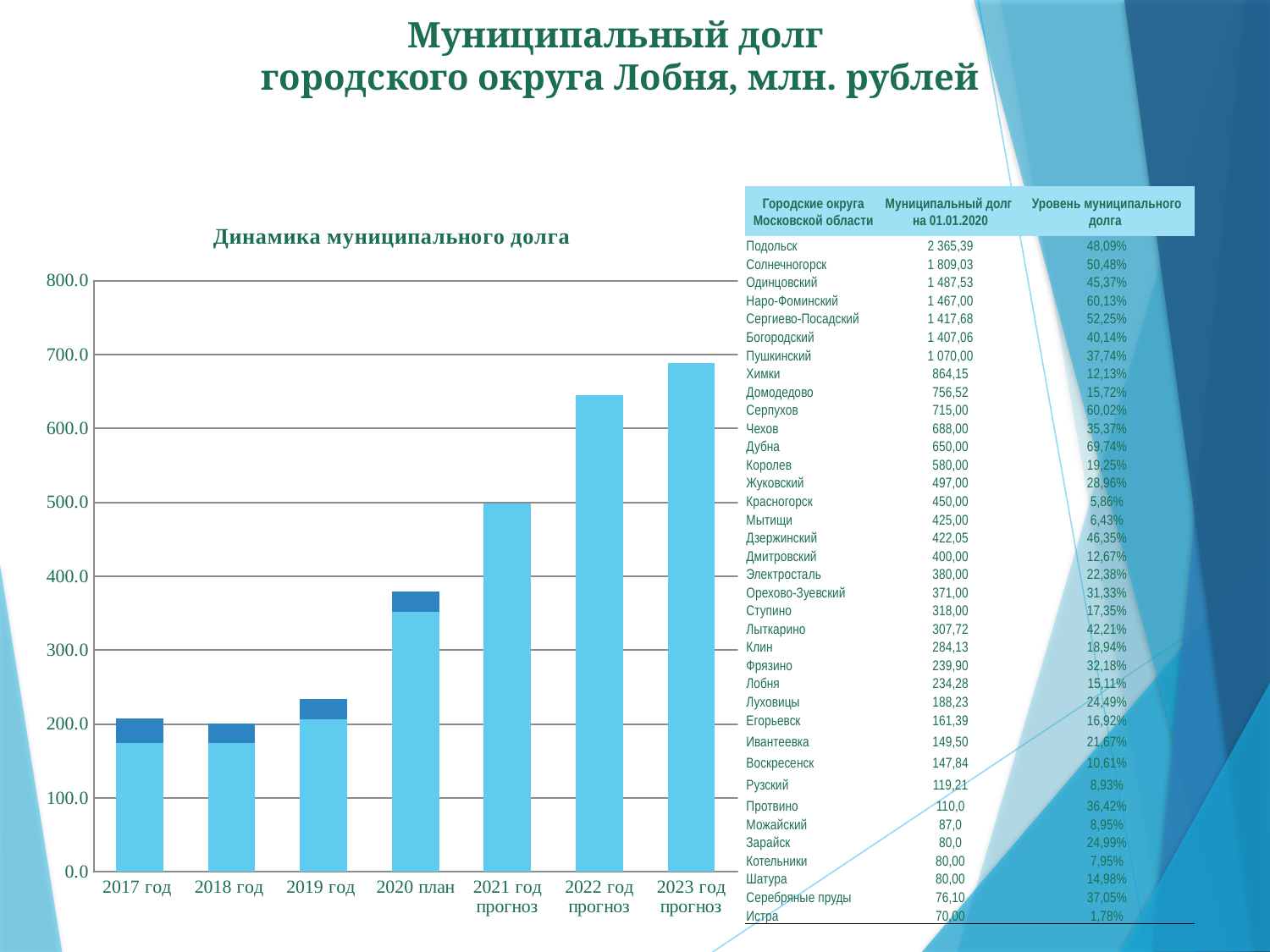
Do the bar values generally rise or fall from 2017 год to 2023 год прогноз? rise What is the title of the chart on the slide? Динамика муниципального долга Is the value for 2023 год прогноз greater or less than 600? greater What type of chart is shown on the slide? bar chart Is the value for 2019 год greater or less than 200? greater Is the value for 2020 план greater or less than 400? less Which is larger, the bar for 2019 год or the bar for 2023 год прогноз? 2023 год прогноз How many categories are shown on the x axis of the chart? 7 Which is larger, the bar for 2022 год прогноз or the bar for 2020 план? 2022 год прогноз Which category has the highest bar in the chart? 2023 год прогноз